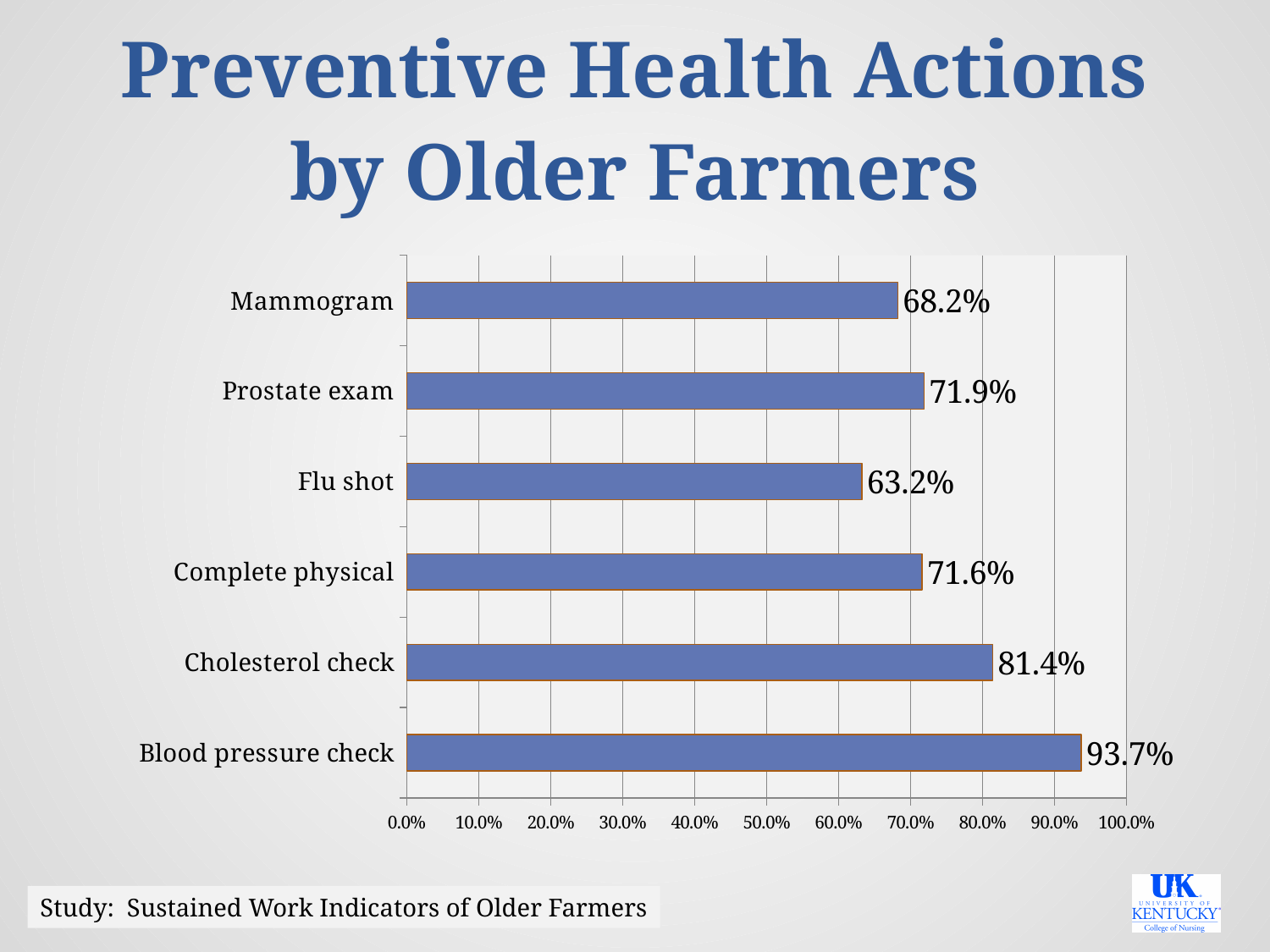
What is the title of the slide? Preventive Health Actions by Older Farmers What is the value for Cholesterol check? 81.4% What is the difference between Blood pressure check and Cholesterol check? 12.3% What kind of chart is shown on the slide? Bar chart What is the value for Flu shot? 63.2% Which preventive health action has the lowest percentage? Flu shot Which preventive health action has the highest percentage? Blood pressure check What is the difference between Mammogram and Flu shot? 5.0% Is the value for Complete physical greater or less than 80.0%? less Which is larger, Prostate exam or Mammogram? Prostate exam What percentage of older farmers had a mammogram? 68.2% How many preventive health actions are shown in the chart? 6